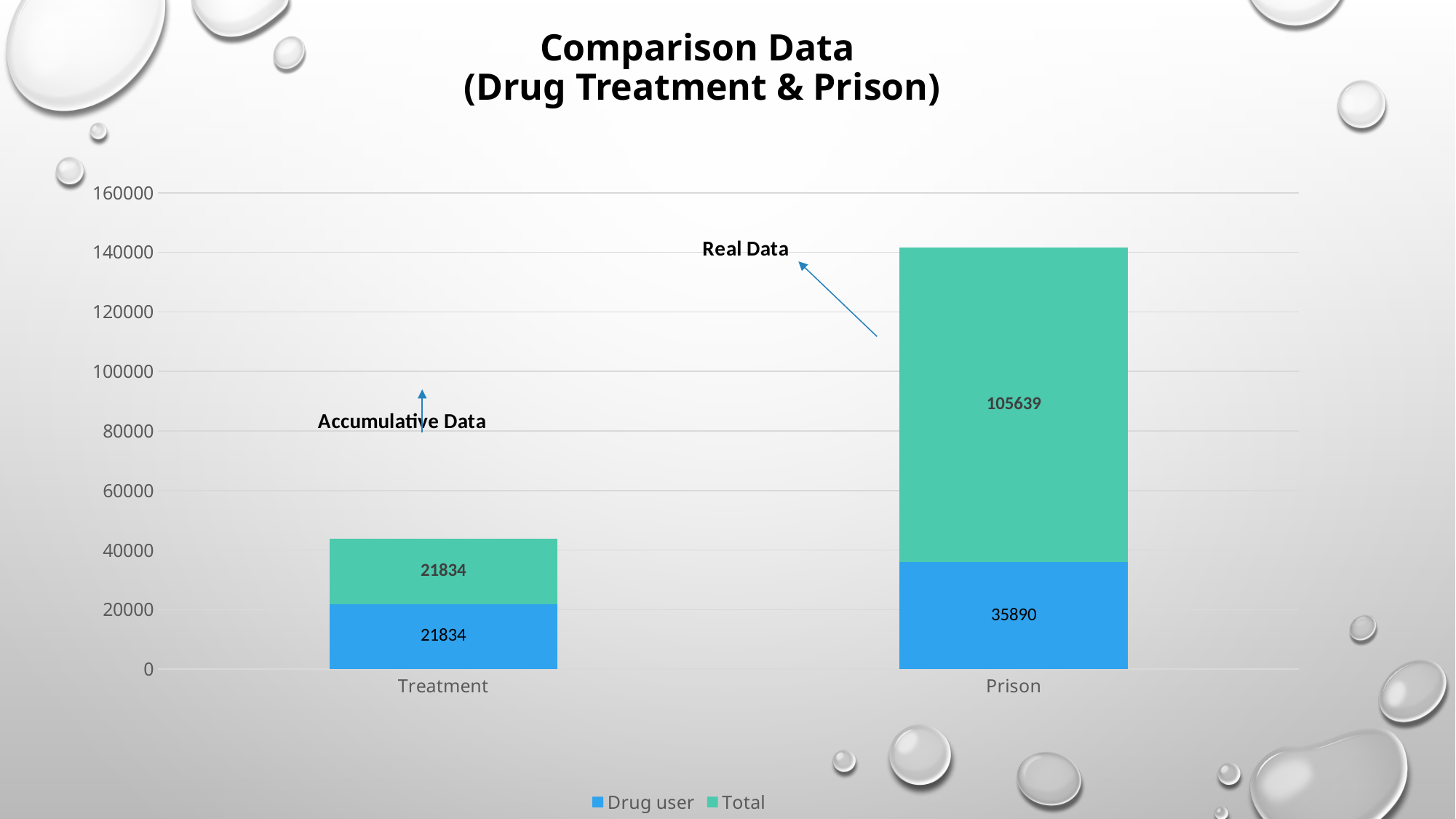
What is the combined height of the stacked bar for Prison? 141529 How many categories are shown on the x axis? 2 Which category has the higher Drug user value, Treatment or Prison? Prison What is the Drug user value for Prison? 35890 What is the difference between the Total series values for Prison and Treatment? 83805 What is the Drug user value for Treatment? 21834 What is the Total series value for Treatment? 21834 What is the difference between the Drug user values for Prison and Treatment? 14056 What is the combined height of the stacked bar for Treatment? 43668 How many series does the legend list? 2 What kind of chart is shown on the slide? Stacked bar chart What is the Total series value for Prison? 105639